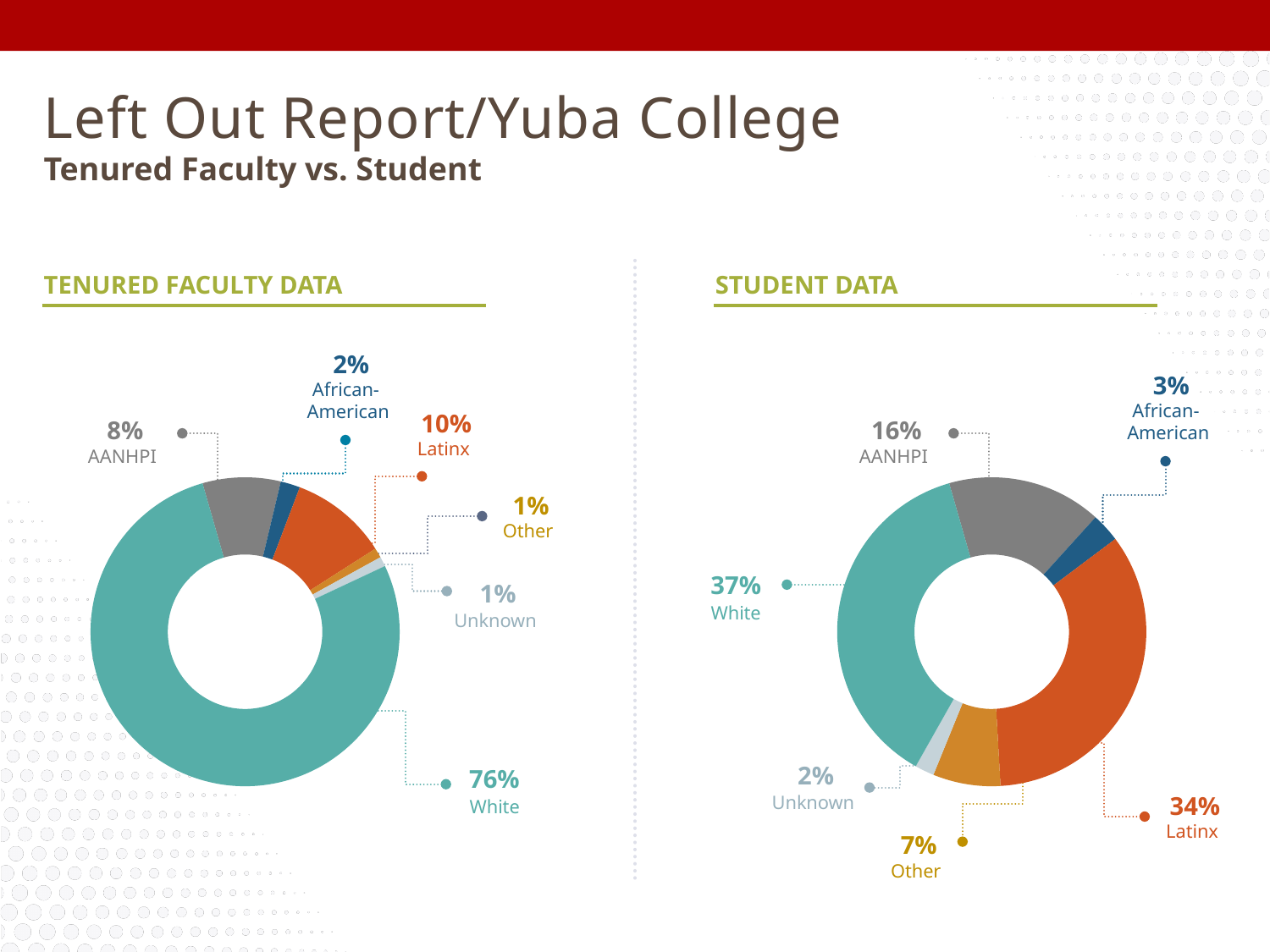
In the Student Data chart, which category has the largest share? White How many categories are shown in the Tenured Faculty Data chart? 6 In the Student Data chart, which category has the smallest share? Unknown In the Tenured Faculty Data chart, what percentage is White? 76% Which is larger in the Student Data chart: the AANHPI share or the Other share? AANHPI What is the difference between the White share in the Tenured Faculty Data chart and the White share in the Student Data chart? 39% In the Student Data chart, what percentage is Latinx? 34% In the Student Data chart, what percentage is Other? 7% What type of chart is used for the Student Data? Donut (pie) chart In the Tenured Faculty Data chart, what percentage is AANHPI? 8% What is the difference between the Latinx share in the Student Data chart and the Latinx share in the Tenured Faculty Data chart? 24% In the Tenured Faculty Data chart, which category has the largest share? White